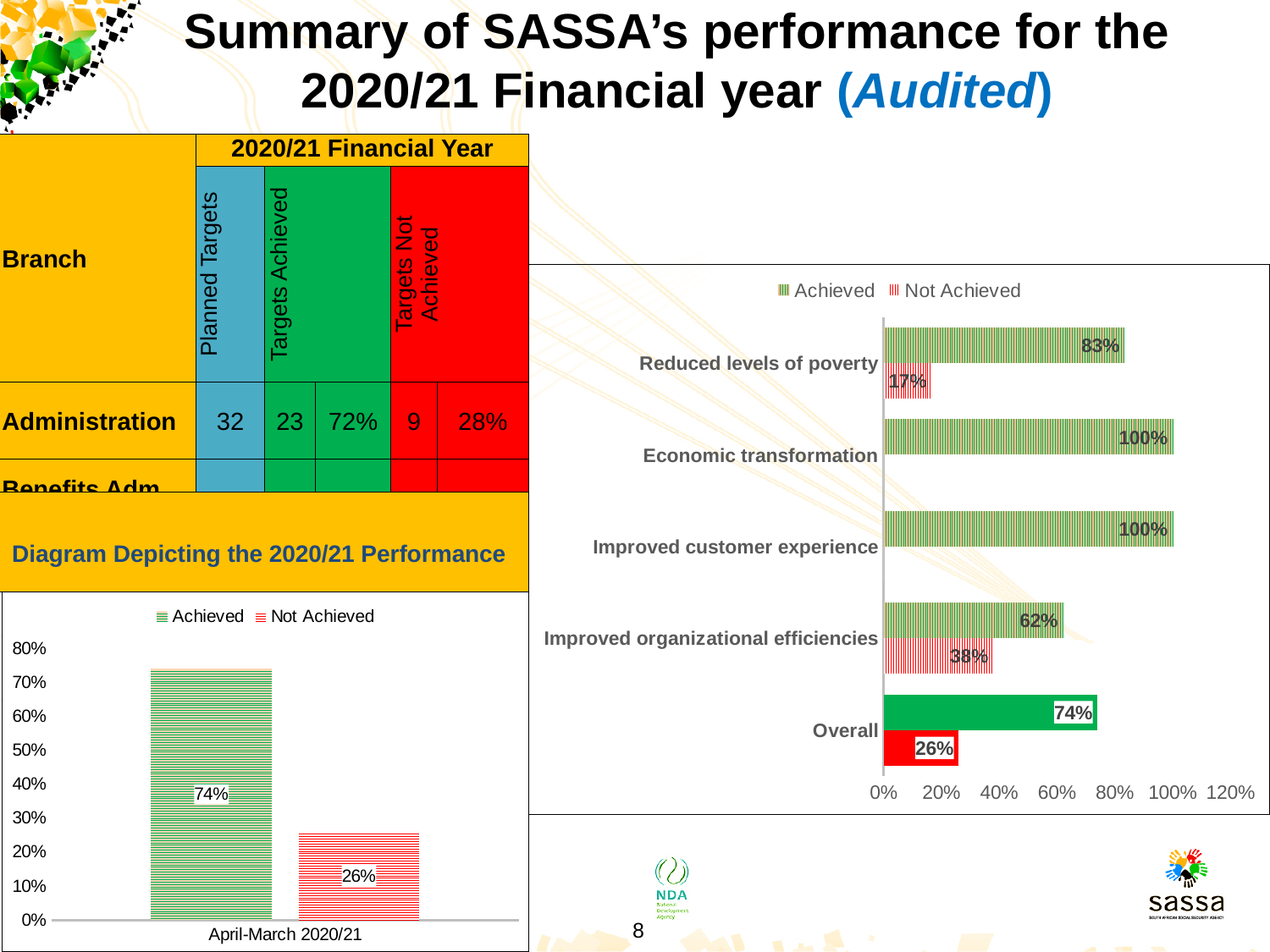
How many categories are shown in the bar chart on the right? 5 In the bar chart on the right, what is the Not Achieved value for Improved organizational efficiencies? 38% In the bar chart on the right, what is the difference between the Achieved and Not Achieved values for Reduced levels of poverty? 66% In the bar chart on the right, which category has the lowest Achieved value? Improved organizational efficiencies How many series does the legend of the bar chart on the right list? 2 In the bar chart on the bottom left, what is the Achieved value for April-March 2020/21? 74% In the bar chart on the right, is the Achieved value for Reduced levels of poverty or for Improved organizational efficiencies larger? Reduced levels of poverty In the bar chart on the right, what is the Not Achieved value for Overall? 26% In the bar chart on the right, what is the Achieved value for Reduced levels of poverty? 83% What kind of chart is the chart on the bottom left of the slide? Bar chart In the bar chart on the bottom left, what is the difference between the Achieved and Not Achieved values? 48% In the bar chart on the right, what is the Achieved value for Economic transformation? 100%